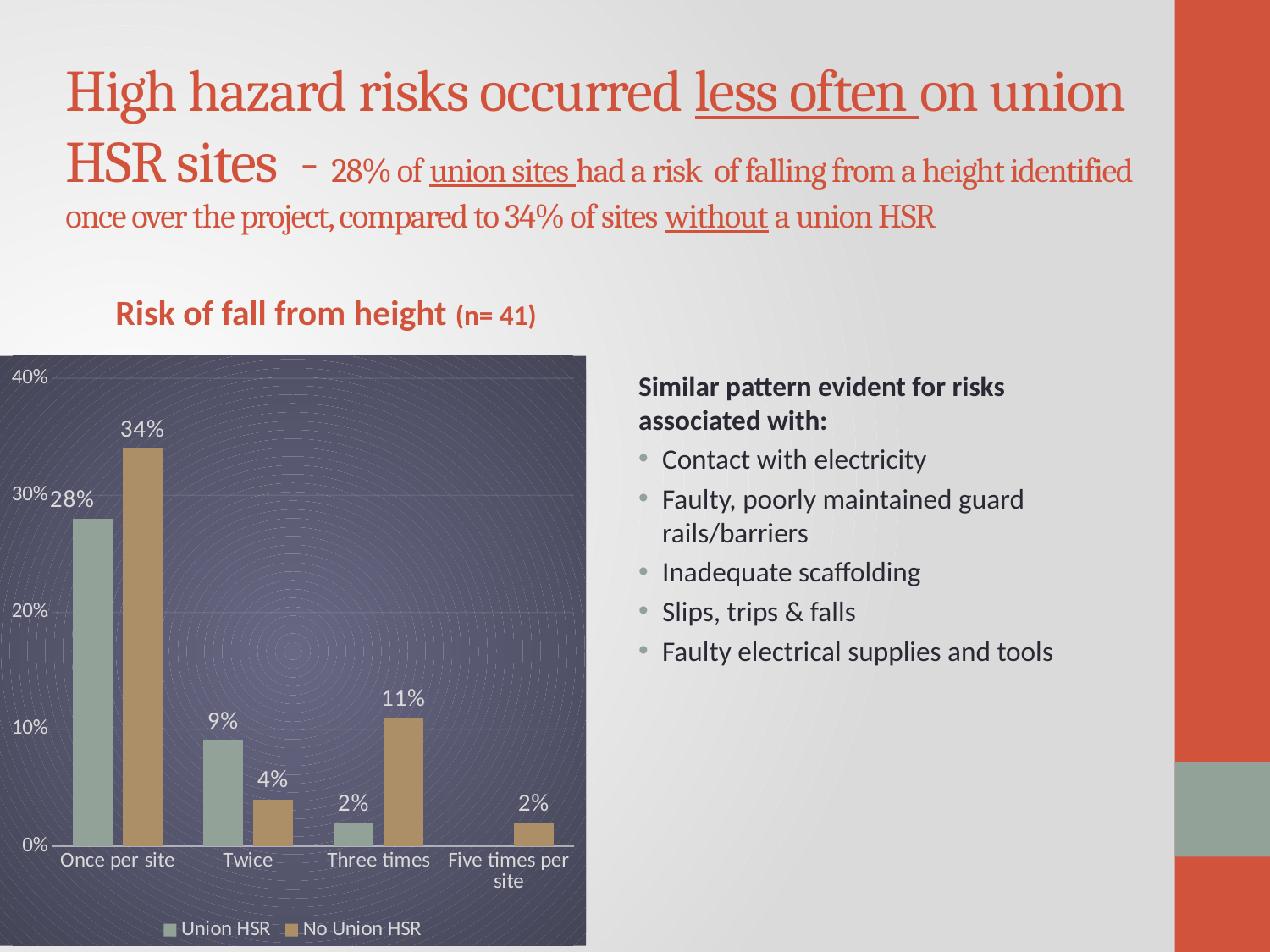
How many categories are shown on the x axis? 4 What is the value for No Union HSR at Three times? 11% How many series does the legend list? 2 What kind of chart is shown on the slide? Bar chart Which category has the highest value for No Union HSR? Once per site What is the difference between the No Union HSR and Union HSR values at Once per site? 6% What is the value for No Union HSR at Once per site? 34% What is the value for Union HSR at Once per site? 28% What is the value for No Union HSR at Five times per site? 2% At Twice, which series has the larger value, Union HSR or No Union HSR? Union HSR What is the value for Union HSR at Twice? 9% What is the difference between the No Union HSR and Union HSR values at Three times? 9%